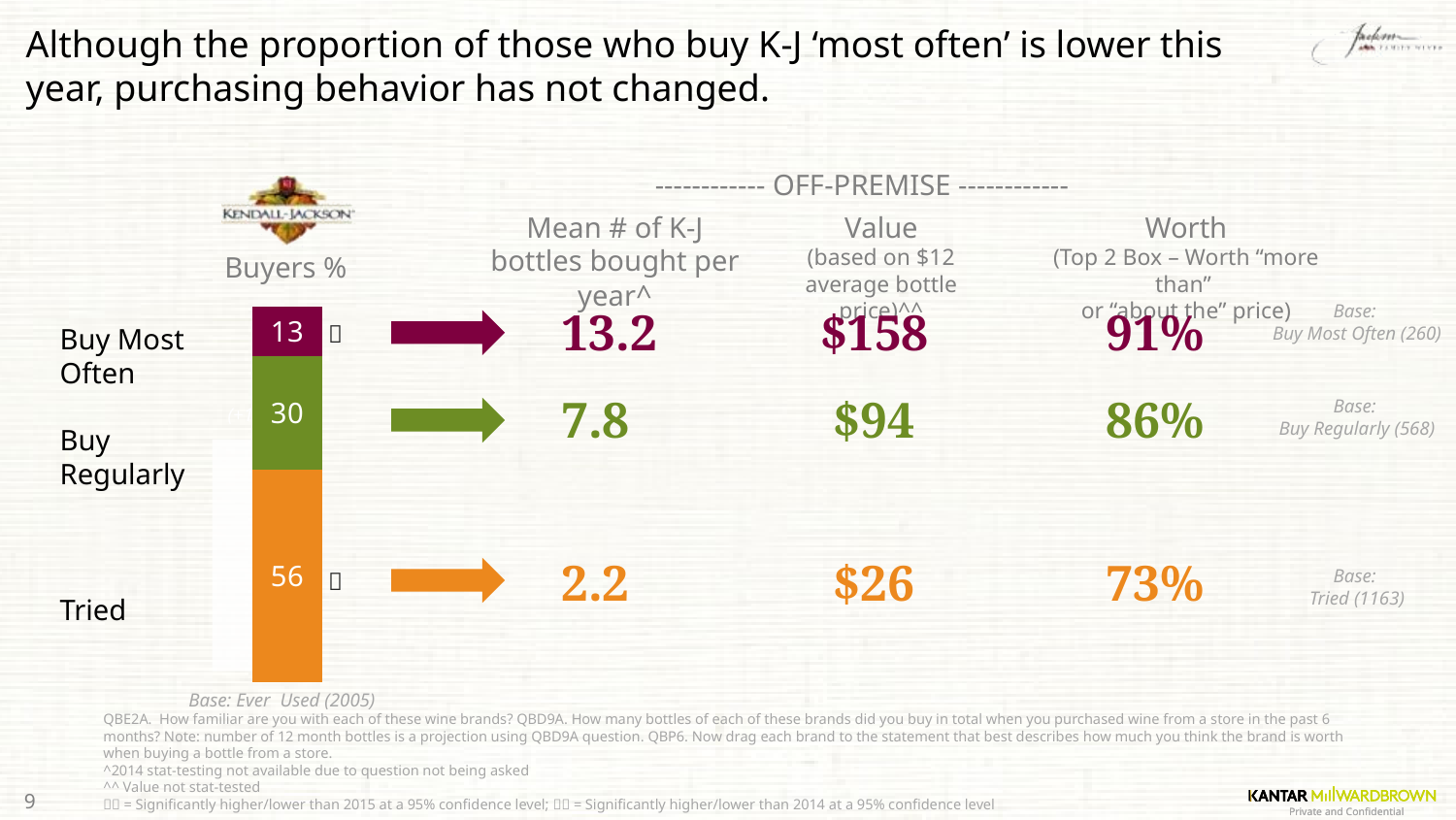
Which segment of the Buyers % bar has the highest value? Tried In the Buyers % bar, what is the value for Tried? 56 What colour is the Tried segment of the Buyers % bar? orange What kind of chart shows the Buyers % figures on the slide? stacked bar chart In the Buyers % bar, what is the difference between the Tried value and the Buy Regularly value? 26 What is the total of the three segments in the Buyers % stacked bar? 99 In the Buyers % bar, which is larger: Buy Regularly or Buy Most Often? Buy Regularly Which segment of the Buyers % bar has the lowest value? Buy Most Often What is the heading printed above the stacked bar? Buyers % How many segments make up the Buyers % stacked bar? 3 In the Buyers % bar, what is the value for Buy Most Often? 13 In the Buyers % bar, what is the value for Buy Regularly? 30